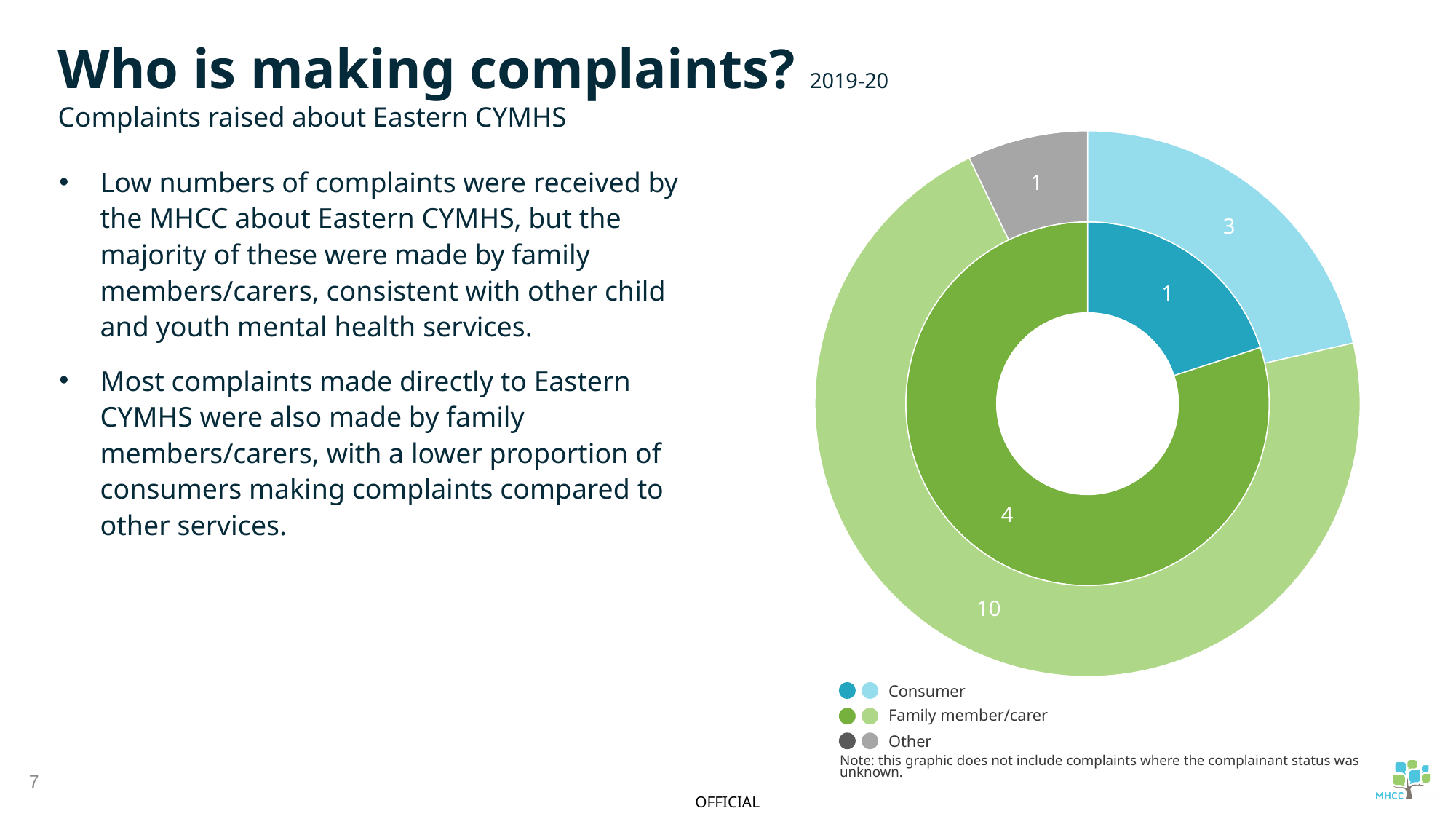
How many categories does the legend of the doughnut chart list? 3 What is the total of the values shown in the outer ring of the doughnut chart? 14 What is the total of the values shown in the inner ring of the doughnut chart? 5 In the inner ring of the doughnut chart, what is the value for Family member/carer? 4 What kind of chart is shown on the slide? Doughnut chart In the outer ring of the doughnut chart, what is the value for Other? 1 In the outer ring of the doughnut chart, what is the value for Family member/carer? 10 What share of the inner ring does Family member/carer represent? 80% Which category has the largest segment in the outer ring of the doughnut chart? Family member/carer In the outer ring of the doughnut chart, what is the value for Consumer? 3 In the outer ring, what is the difference between the Family member/carer value and the Consumer value? 7 In the inner ring of the doughnut chart, what is the value for Consumer? 1